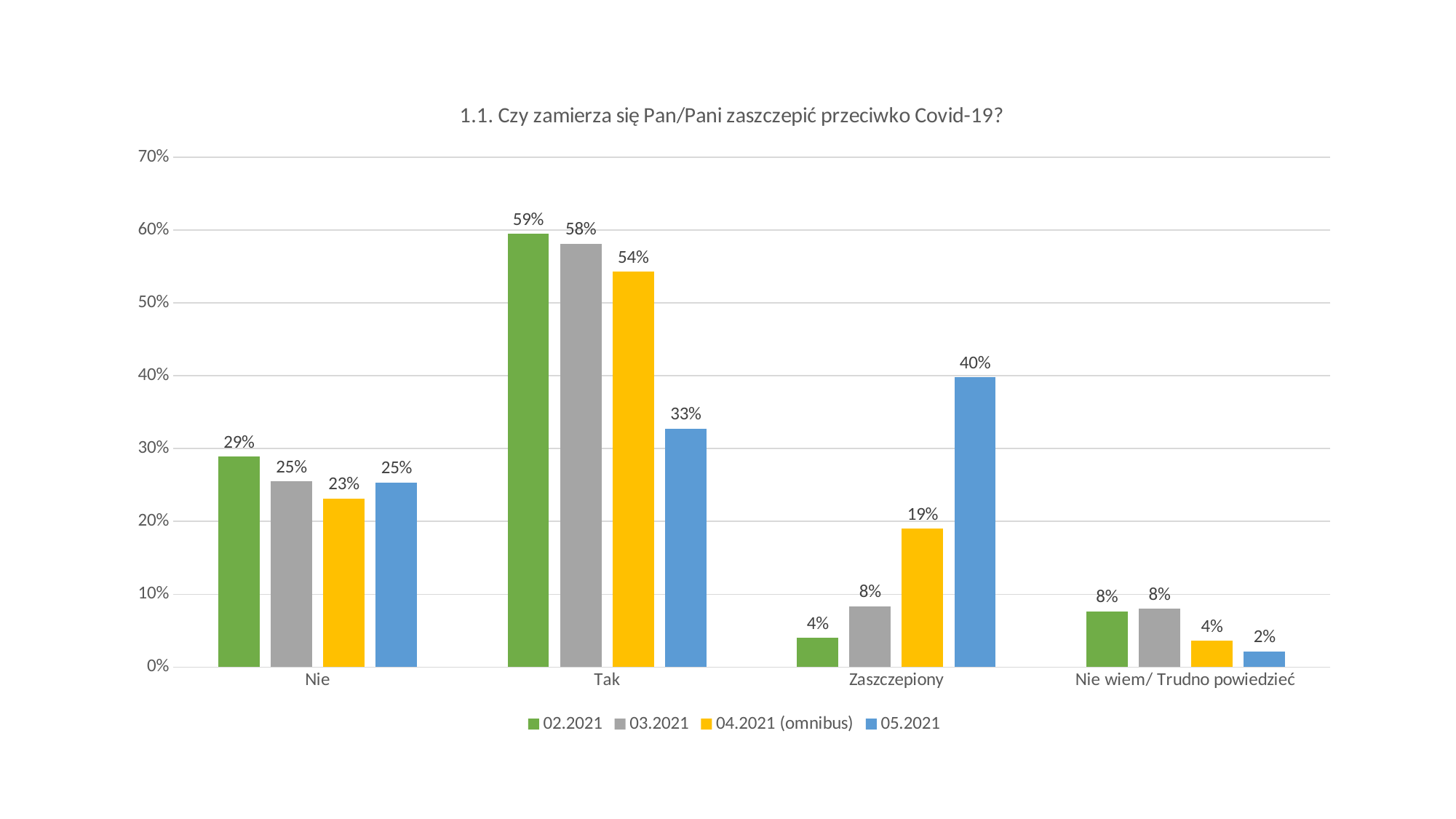
Which category has the lowest value in the 02.2021 series? Zaszczepiony How many categories are shown on the x axis? 4 What is the value for "Tak" in the 02.2021 series? 59% What is the title of the chart? 1.1. Czy zamierza się Pan/Pani zaszczepić przeciwko Covid-19? Which is larger for "Zaszczepiony": the 03.2021 value or the 04.2021 (omnibus) value? 04.2021 (omnibus) What is the value for "Nie" in the 04.2021 (omnibus) series? 23% What is the value for "Zaszczepiony" in the 05.2021 series? 40% Which category has the highest value in the 05.2021 series? Zaszczepiony What is the value for "Nie wiem/ Trudno powiedzieć" in the 05.2021 series? 2% What is the difference between the 02.2021 and 05.2021 values for "Tak"? 26% What kind of chart is shown on the slide? Bar chart How many series does the legend list? 4